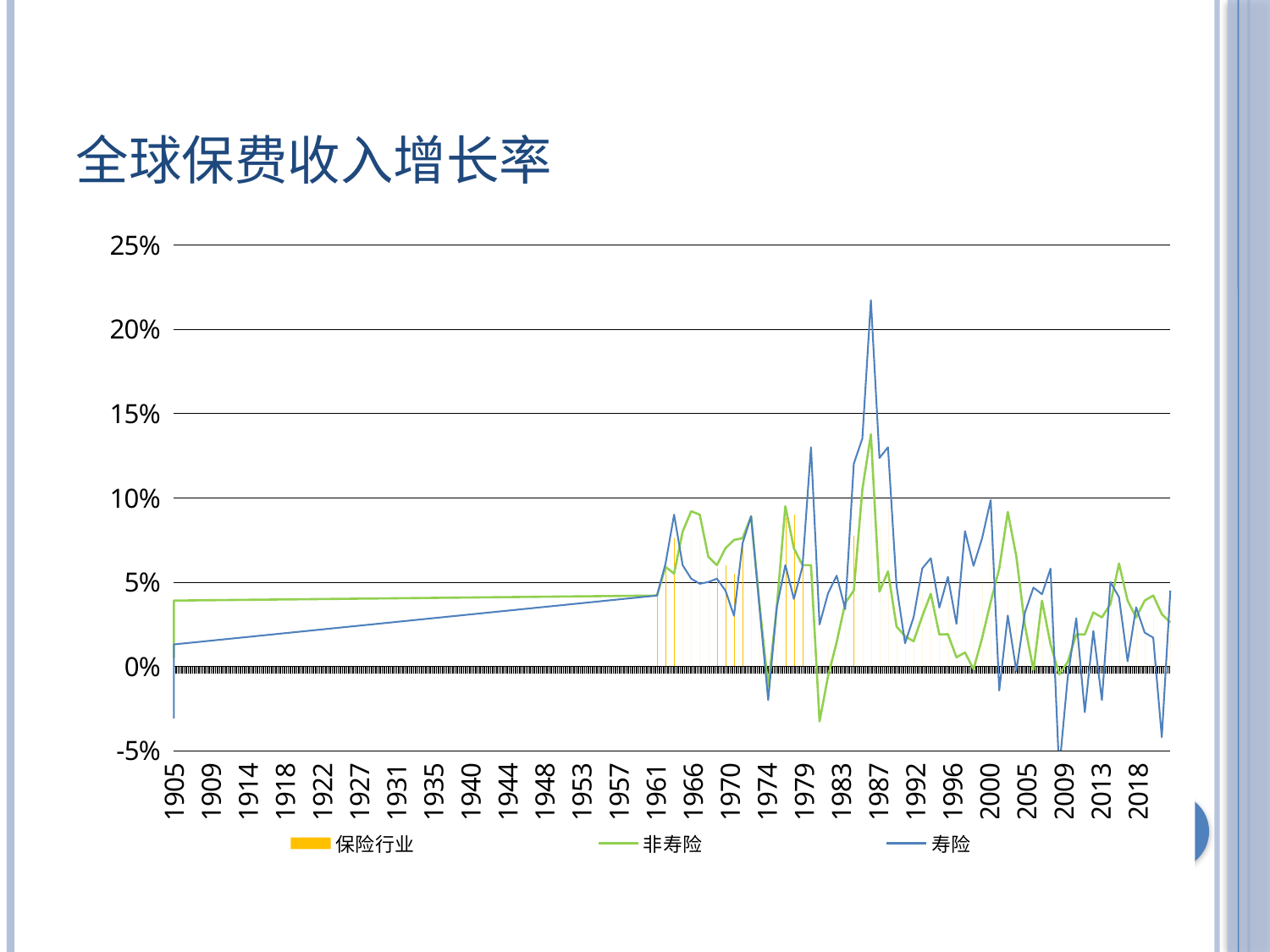
Which series reaches the highest value anywhere on the chart? 寿险 Is the peak value of the 寿险 series greater or less than 20%? greater Is the peak value of the 非寿险 series greater or less than 10%? greater Is the lowest value of the 非寿险 series around 1979 greater or less than 0%? less How many series does the chart legend list? 3 At the 1987 peak, which series is higher, 寿险 or 非寿险? 寿险 What is the title of the chart? 全球保费收入增长率 What colour is the 寿险 line in the chart? blue Near which labelled year does the 寿险 series reach its highest peak? 1987 What type of chart is used to plot the 寿险 and 非寿险 series? line chart